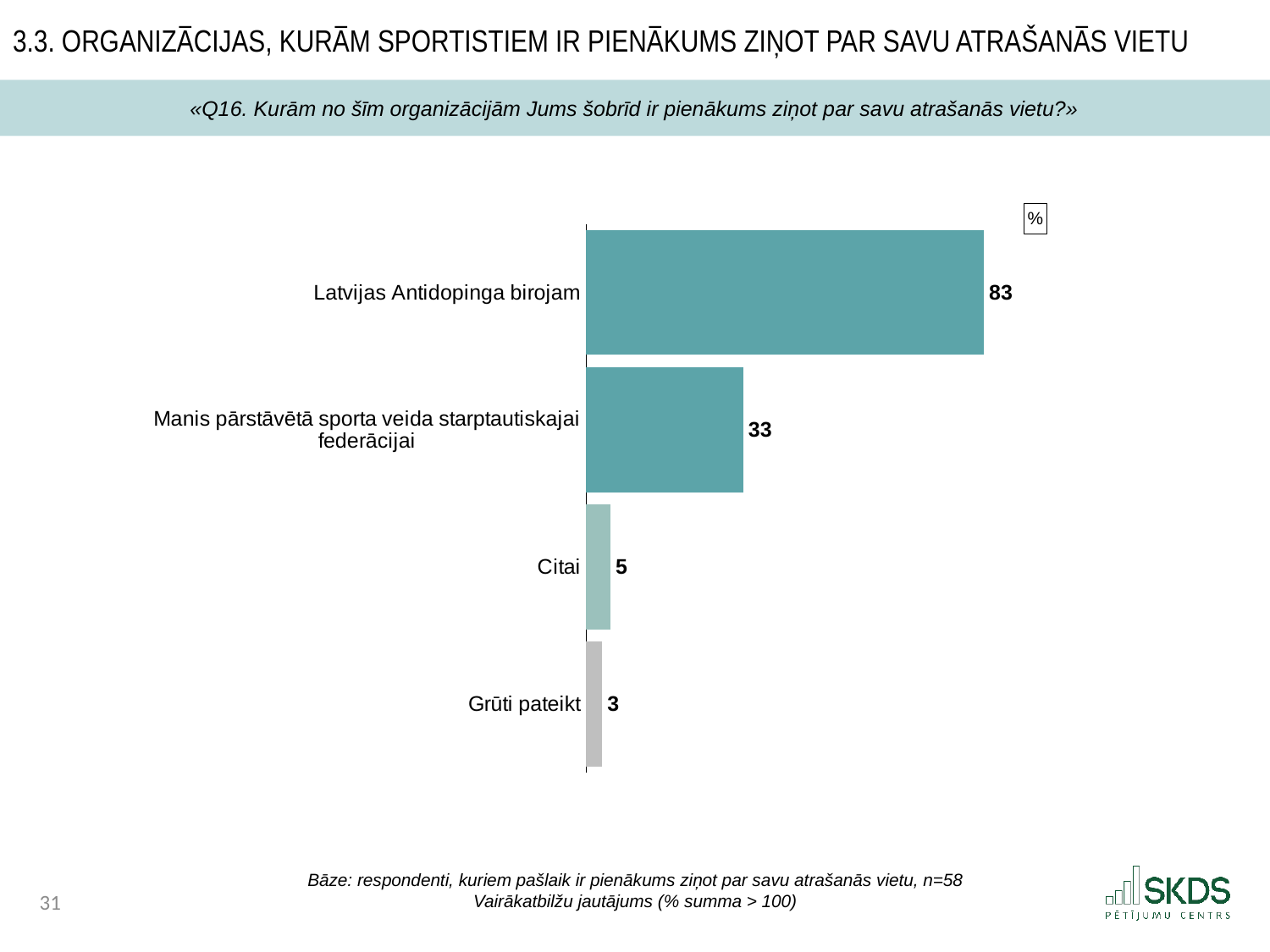
What is the value for Grūti pateikt? 3 What is the value for Latvijas Antidopinga birojam? 83 How many categories are shown in the chart? 4 What is the value for Manis pārstāvētā sporta veida starptautiskajai federācijai? 33 What is the value for Citai? 5 What kind of chart is shown on the slide? Bar chart What is the difference between the values for Latvijas Antidopinga birojam and Manis pārstāvētā sporta veida starptautiskajai federācijai? 50 What unit are the values in the chart expressed in? % What is the difference between the values for Citai and Grūti pateikt? 2 Which category has the highest value? Latvijas Antidopinga birojam Which category has the lowest value? Grūti pateikt Which is larger, the value for Citai or the value for Grūti pateikt? Citai